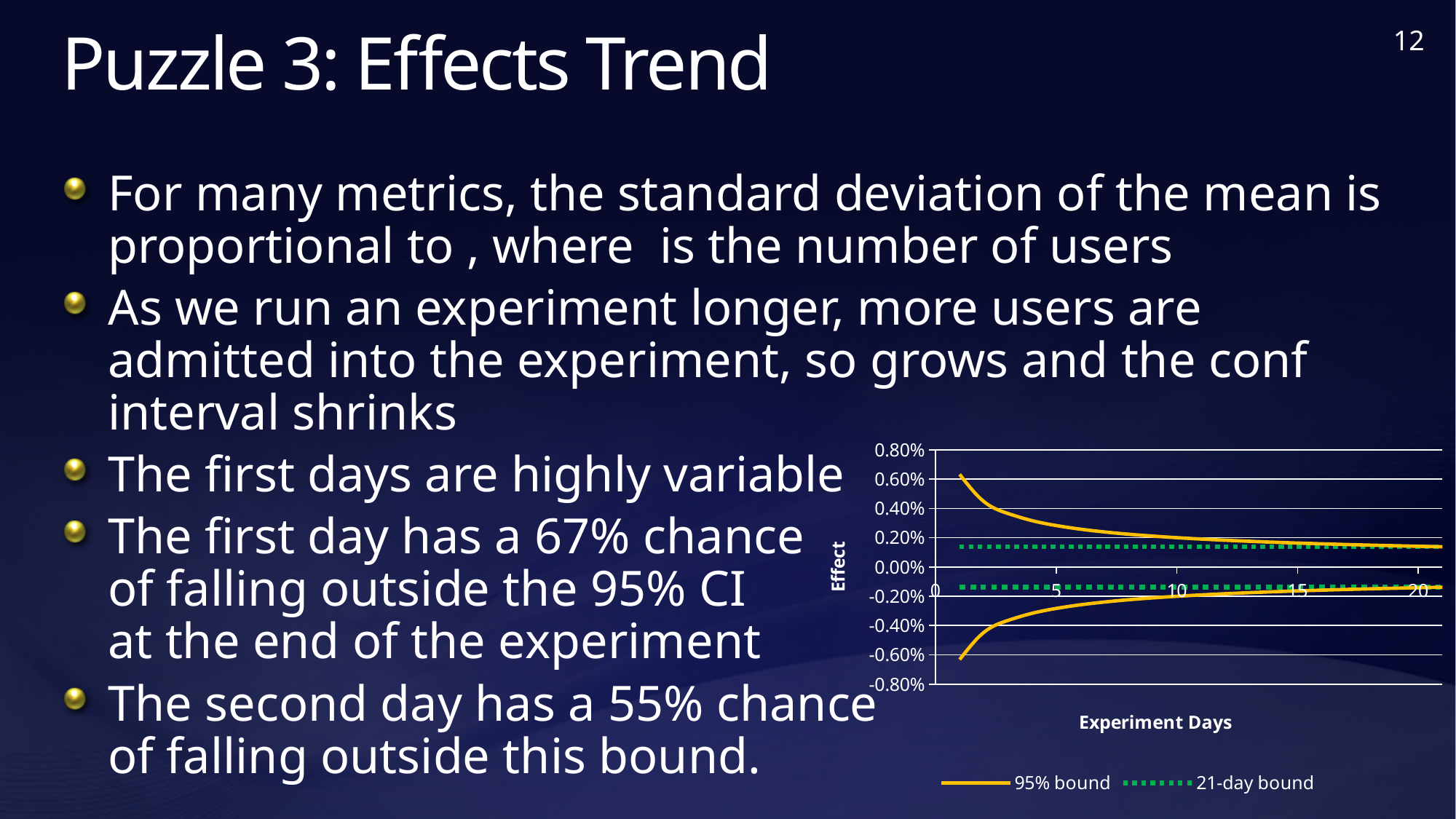
Which series is wider at day 5: the 95% bound or the 21-day bound? 95% bound Does the upper 95% bound line rise or fall as Experiment Days increase? Fall Is the upper 21-day bound line greater or less than 0.40%? less How many series does the chart's legend list? 2 Does the lower 95% bound line rise or fall as Experiment Days increase? Rise Is the upper 95% bound at day 20 greater or less than 0.40%? less What are the two series named in the chart's legend? 95% bound and 21-day bound What kind of chart is shown on the slide? Line chart Is the lower 95% bound at day 1 greater or less than -0.40%? less What is the highest value shown on the chart's y axis? 0.80% What is the title of the chart's x axis? Experiment Days